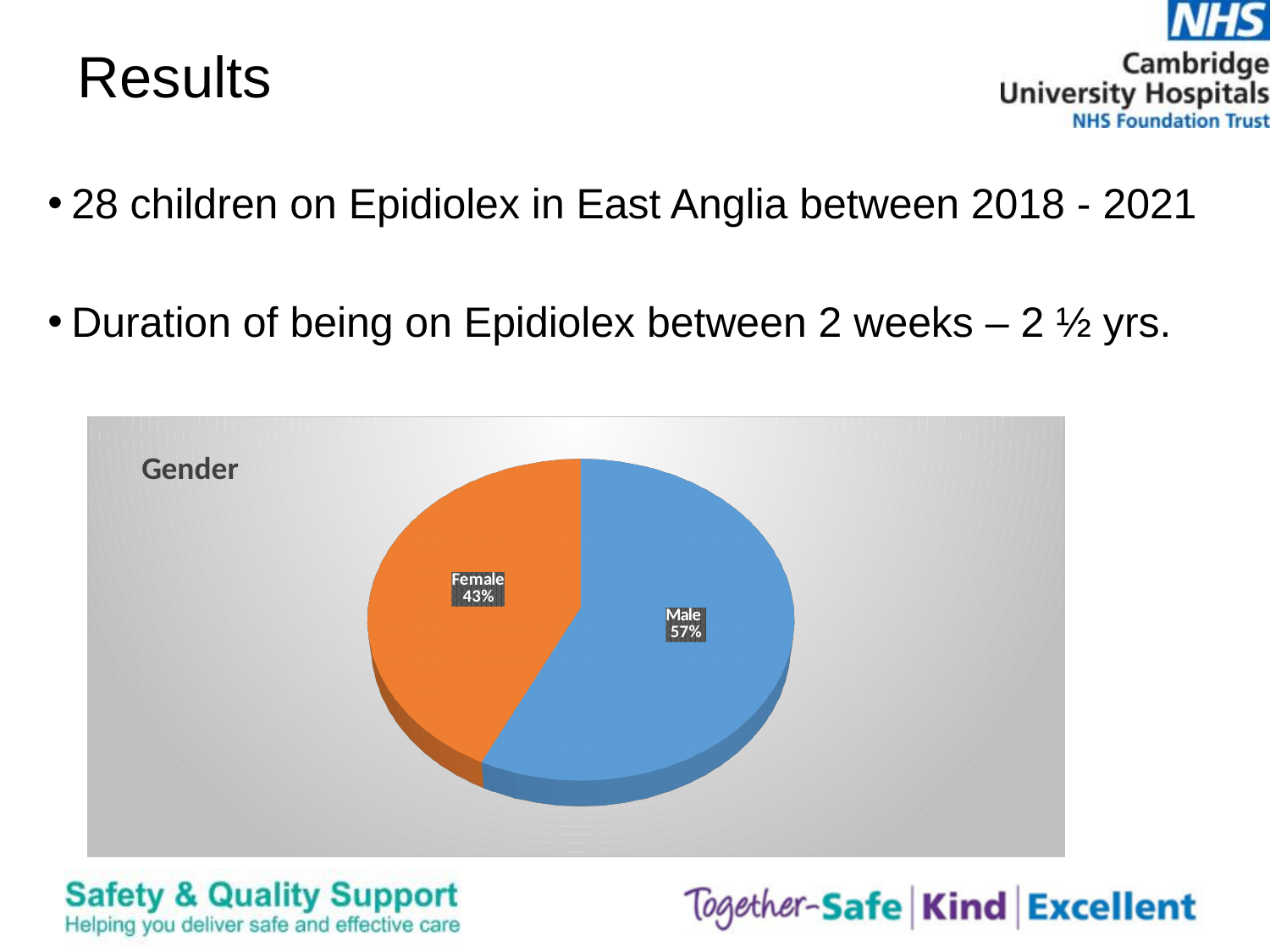
What percentage of the pie is Male? 57% What kind of chart is shown on the slide? Pie chart Which slice of the pie is the largest? Male How many slices does the pie chart have? 2 Which slice of the pie is the smallest? Female What is the title of the chart? Gender What colour is the Female slice of the pie? Orange What is the difference in percentage points between the Male and Female slices? 14 What percentage of the pie is Female? 43% Which is larger, the Male slice or the Female slice? Male What share of the pie does the Male slice represent? 57%